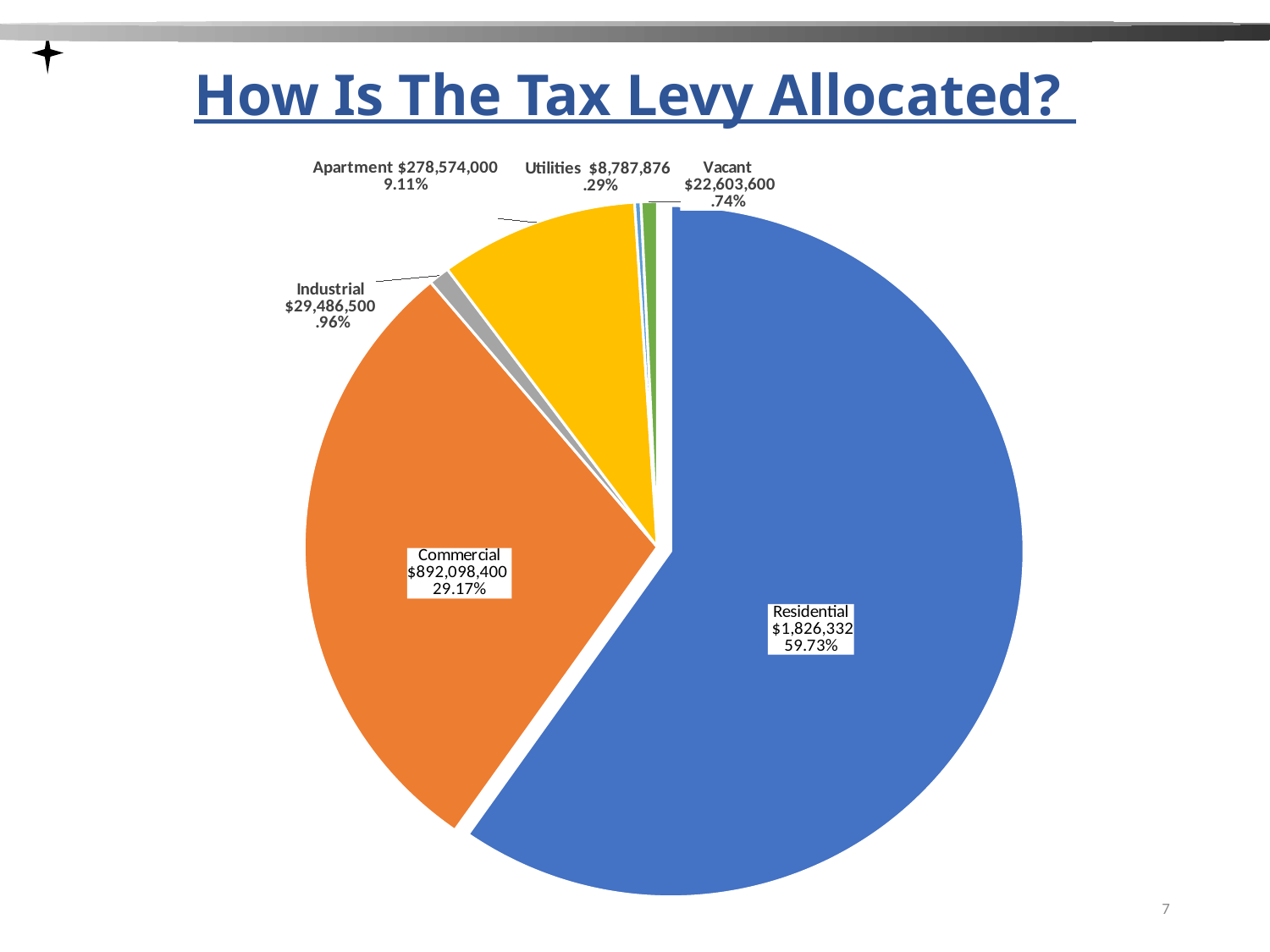
What is the dollar value shown for the Commercial slice? $892,098,400 What is the dollar value shown for Utilities? $8,787,876 How many categories are shown in the pie chart? 6 Which category has the smallest share of the tax levy? Utilities Which category has the largest share of the tax levy? Residential What percentage share is shown for Vacant? .74% What is the title of the slide containing the chart? How Is The Tax Levy Allocated? Which has a larger share, Commercial or Apartment? Commercial What percentage of the tax levy is allocated to Residential? 59.73% What is the dollar value shown for Industrial? $29,486,500 What kind of chart is shown on the slide? pie chart What percentage share does the Apartment slice have? 9.11%